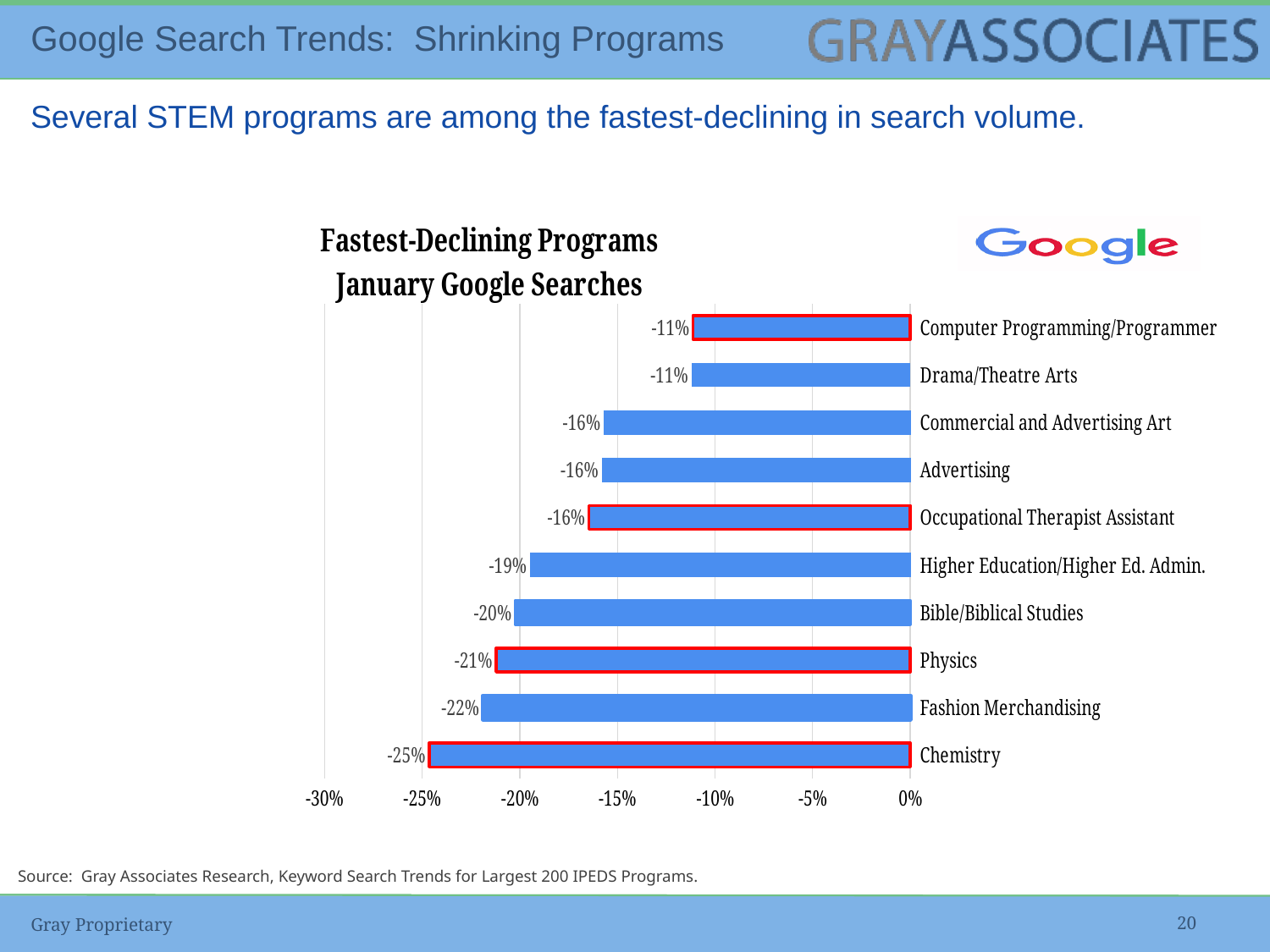
How many programs are highlighted with a red outline? 4 What is the difference between the values for Chemistry and Physics? 4 percentage points What is the value for Bible/Biblical Studies? -20% What is the value for Physics? -21% How many programs are shown in the chart? 10 Which program shows the largest decline? Chemistry What is the title of the chart? Fastest-Declining Programs January Google Searches What kind of chart is this? Bar chart What is the value for Fashion Merchandising? -22% What is the value for Chemistry? -25% Which has a larger decline, Fashion Merchandising or Higher Education/Higher Ed. Admin.? Fashion Merchandising What is the value for Occupational Therapist Assistant? -16%